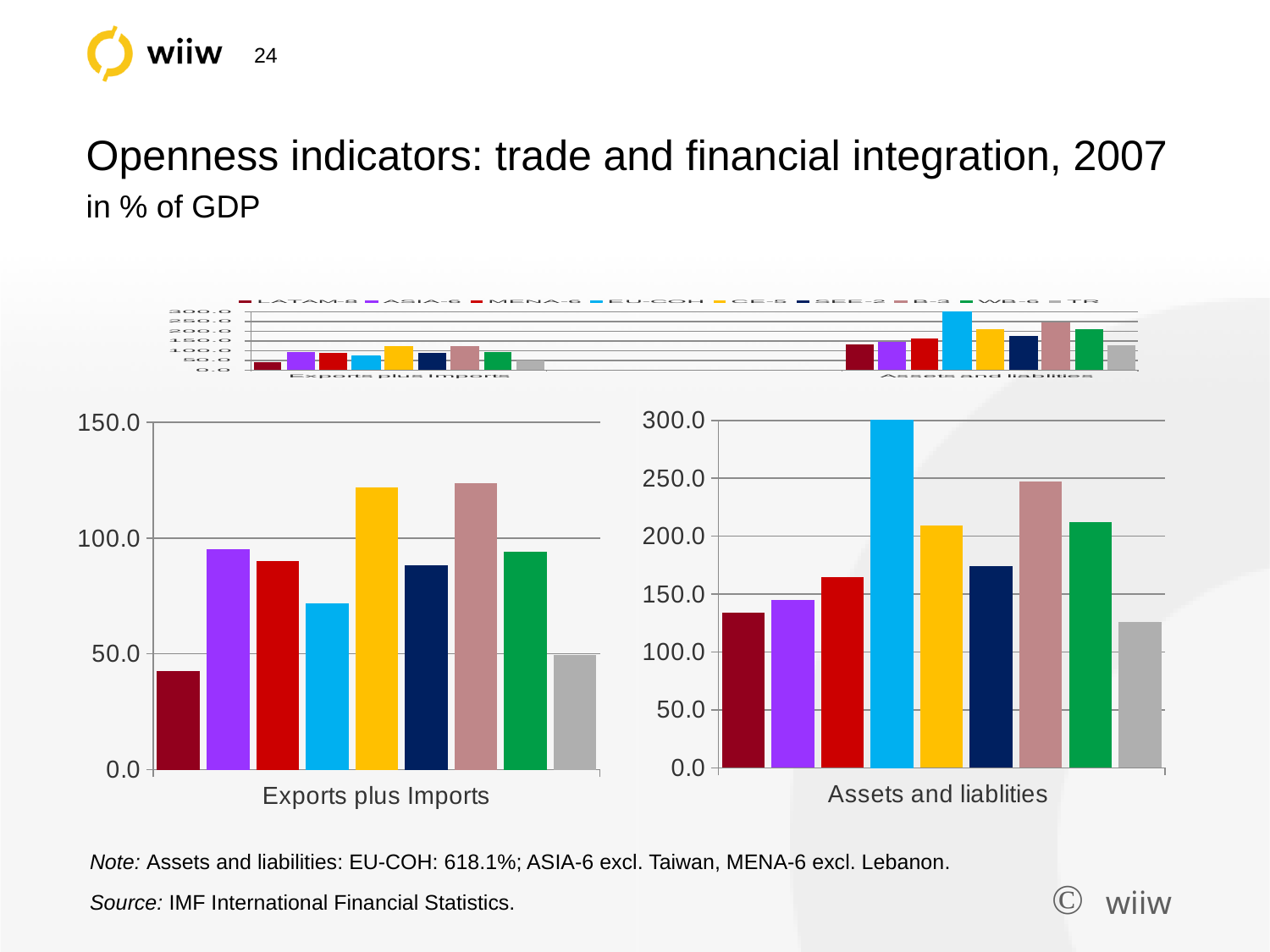
In the 'Assets and liablities' chart, which bar is the highest? the light blue (fourth) bar In the 'Exports plus Imports' chart, is the value of the yellow bar greater or less than 100? greater In the 'Exports plus Imports' chart, which is larger: the purple bar or the light blue bar? the purple bar What kind of chart is the 'Exports plus Imports' chart? bar chart In the 'Assets and liablities' chart, is the value of the grey (last) bar greater or less than 100? greater According to the note below the charts, what is the assets and liabilities value for EU-COH? 618.1% In the 'Assets and liablities' chart, is the value of the light blue bar greater or less than 250? greater In the 'Assets and liablities' chart, which is larger: the pink bar or the green bar? the pink bar How many bars are plotted in the 'Exports plus Imports' chart? 9 What is the category label on the x axis of the right-hand chart? Assets and liablities How many bars are plotted in the 'Assets and liablities' chart? 9